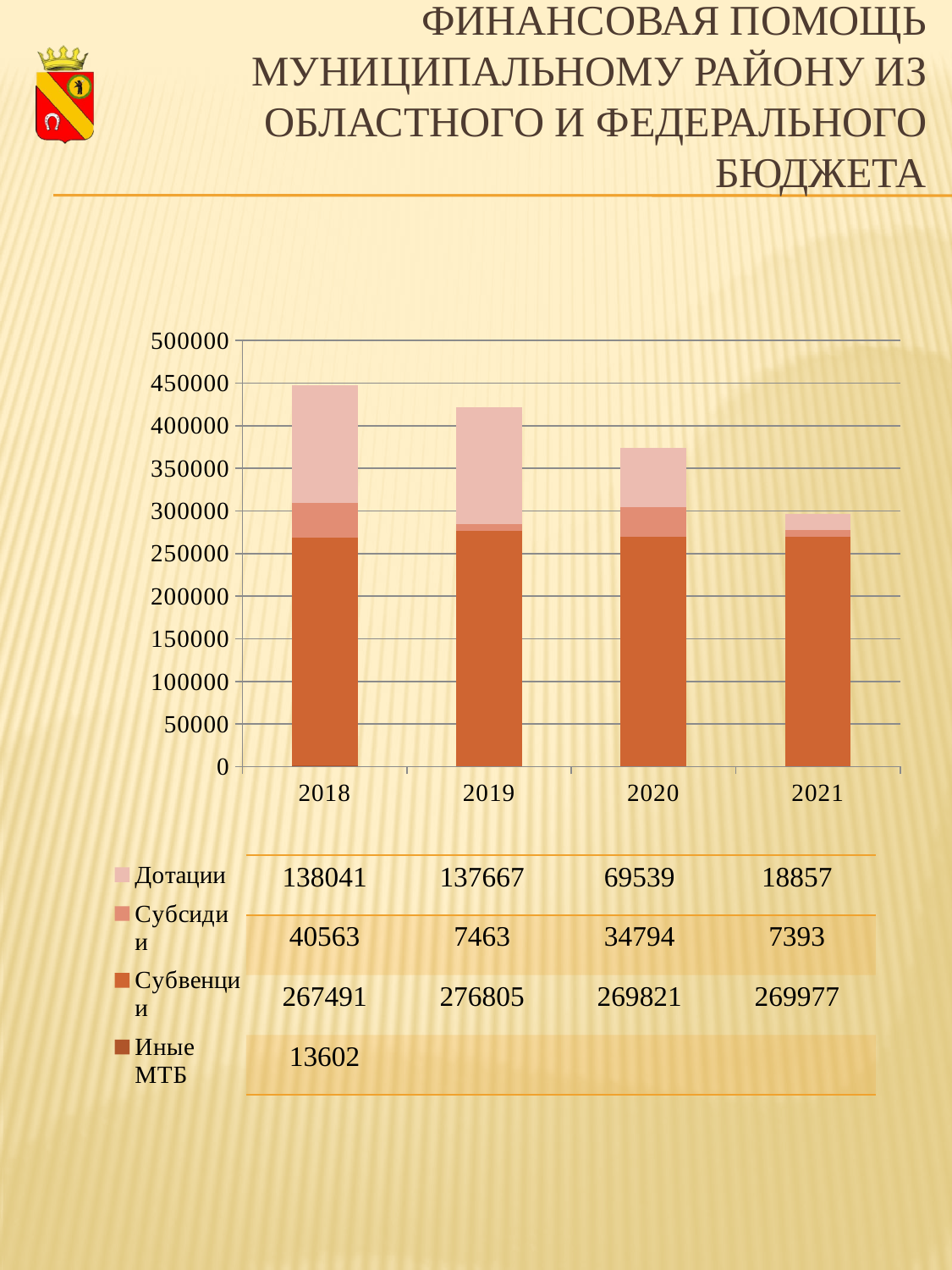
In which year is the value of Дотации the highest? 2018 How many years are shown on the x axis? 4 Is the total height of the 2018 bar greater or less than 400000? greater What is the difference between the Дотации values for 2018 and 2021? 119184 Which year has the larger Субвенции value, 2019 or 2020? 2019 What is the value of Иные МТБ for 2018? 13602 What is the value of Субсидии for 2020? 34794 How many series does the legend list? 4 In which year is the value of Дотации the lowest? 2021 What is the value of Дотации for 2018? 138041 What is the total of the stacked bar for 2021? 296227 What is the value of Субвенции for 2019? 276805